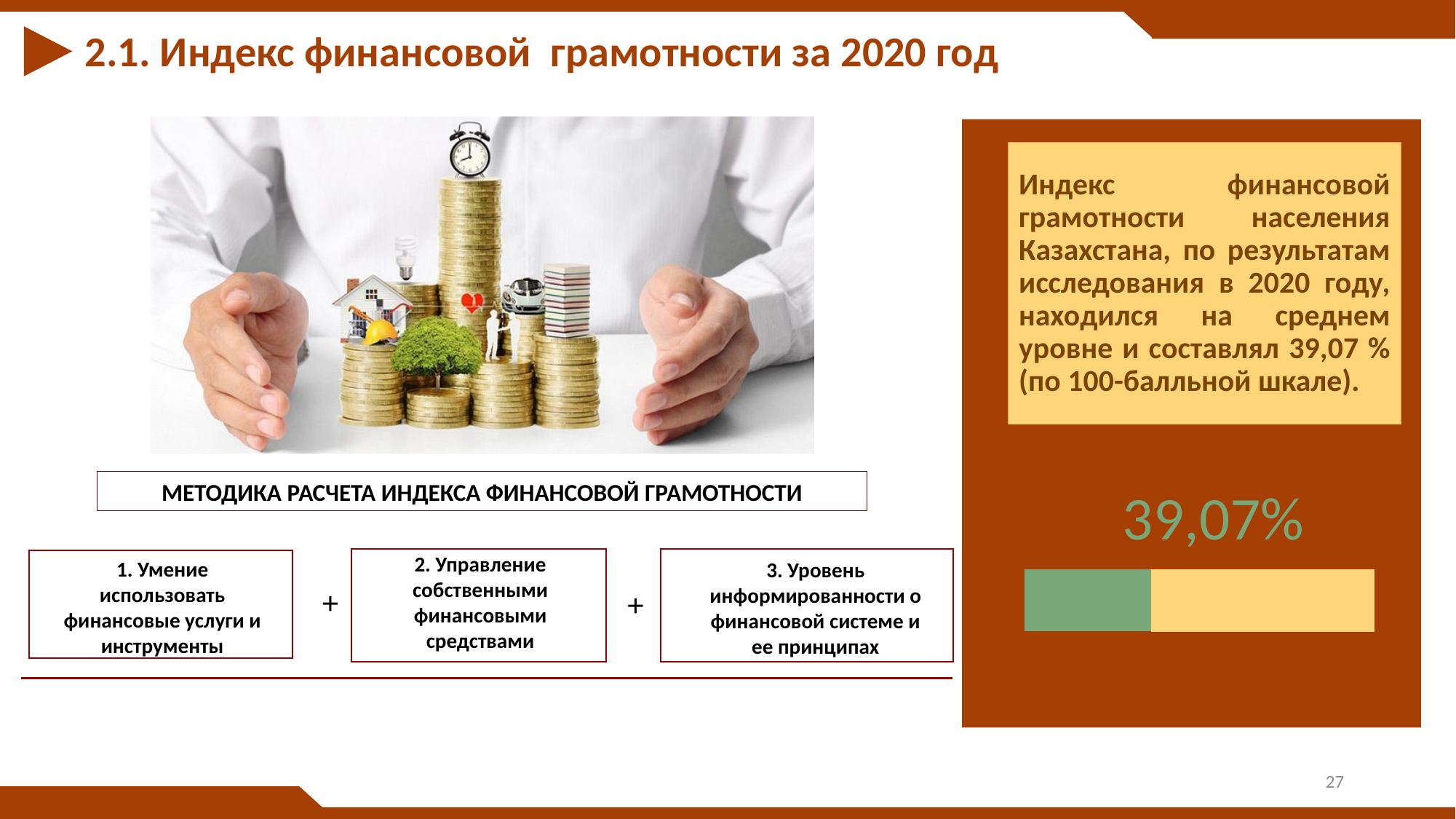
What kind of chart is shown on the right side of the slide below the text box? bar chart Is the value shown by the bar chart on the right greater or less than 50%? less What value does the bar chart on the right side of the slide display? 39,07% What colour is the unfilled remainder of the bar in the chart on the right side of the slide? yellow How many values are plotted in the bar chart on the right side of the slide? 2 What colour is the filled portion of the bar in the chart on the right side of the slide? green According to the chart on the right, what was the financial literacy index of Kazakhstan's population in 2020? 39,07%